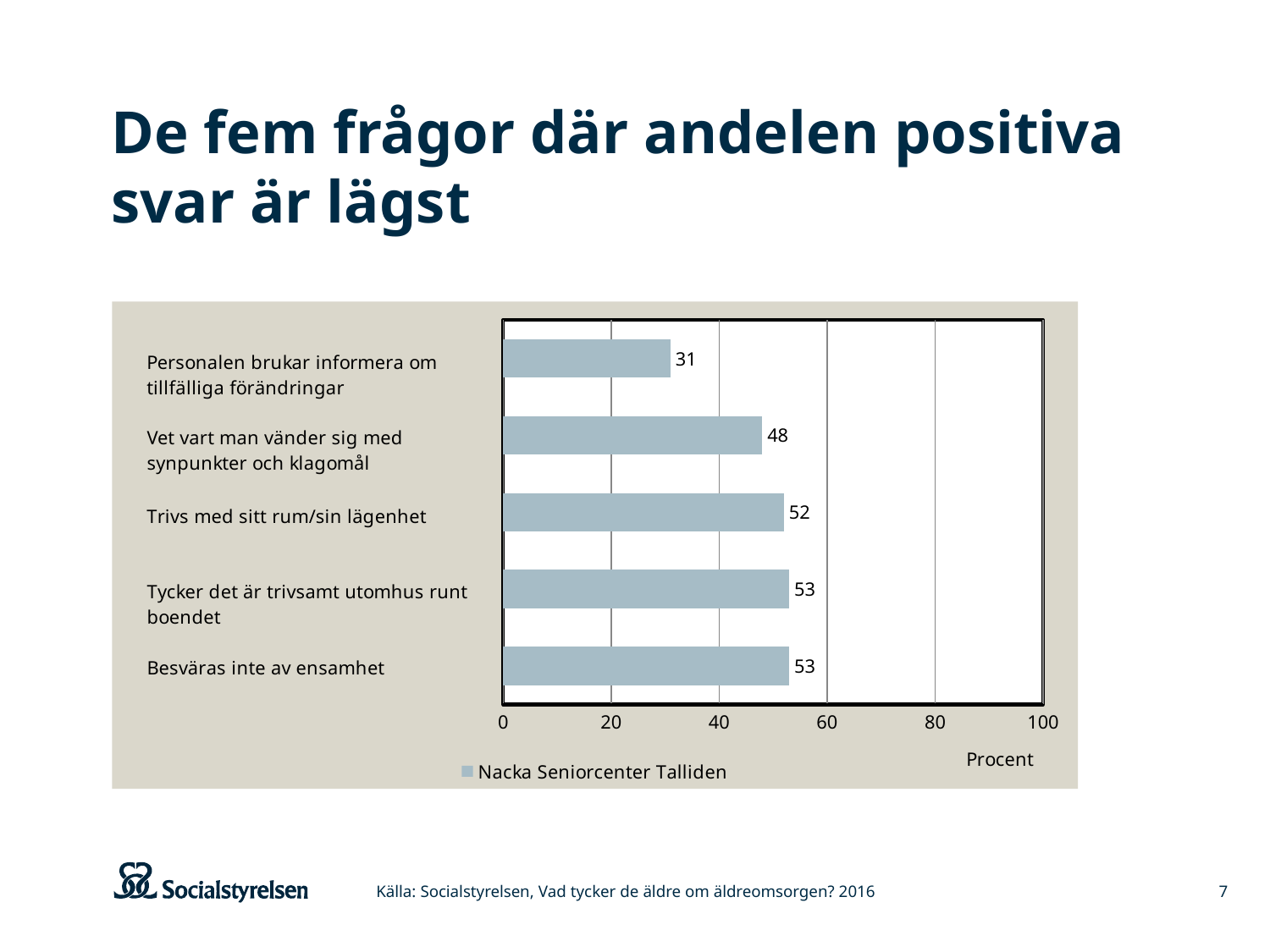
What is the difference between the values for "Tycker det är trivsamt utomhus runt boendet" and "Trivs med sitt rum/sin lägenhet"? 1 What kind of chart is shown on the slide? bar chart Is the value for "Vet vart man vänder sig med synpunkter och klagomål" greater or less than 40? greater Which category has the lowest value? Personalen brukar informera om tillfälliga förändringar What is the value for "Trivs med sitt rum/sin lägenhet"? 52 What is the difference between the values for "Vet vart man vänder sig med synpunkter och klagomål" and "Personalen brukar informera om tillfälliga förändringar"? 17 How many categories are shown in the chart? 5 What is the value for "Vet vart man vänder sig med synpunkter och klagomål"? 48 What series name does the legend show? Nacka Seniorcenter Talliden Which is larger: the value for "Trivs med sitt rum/sin lägenhet" or the value for "Personalen brukar informera om tillfälliga förändringar"? Trivs med sitt rum/sin lägenhet What is the value for "Besväras inte av ensamhet"? 53 What is the value for "Personalen brukar informera om tillfälliga förändringar"? 31